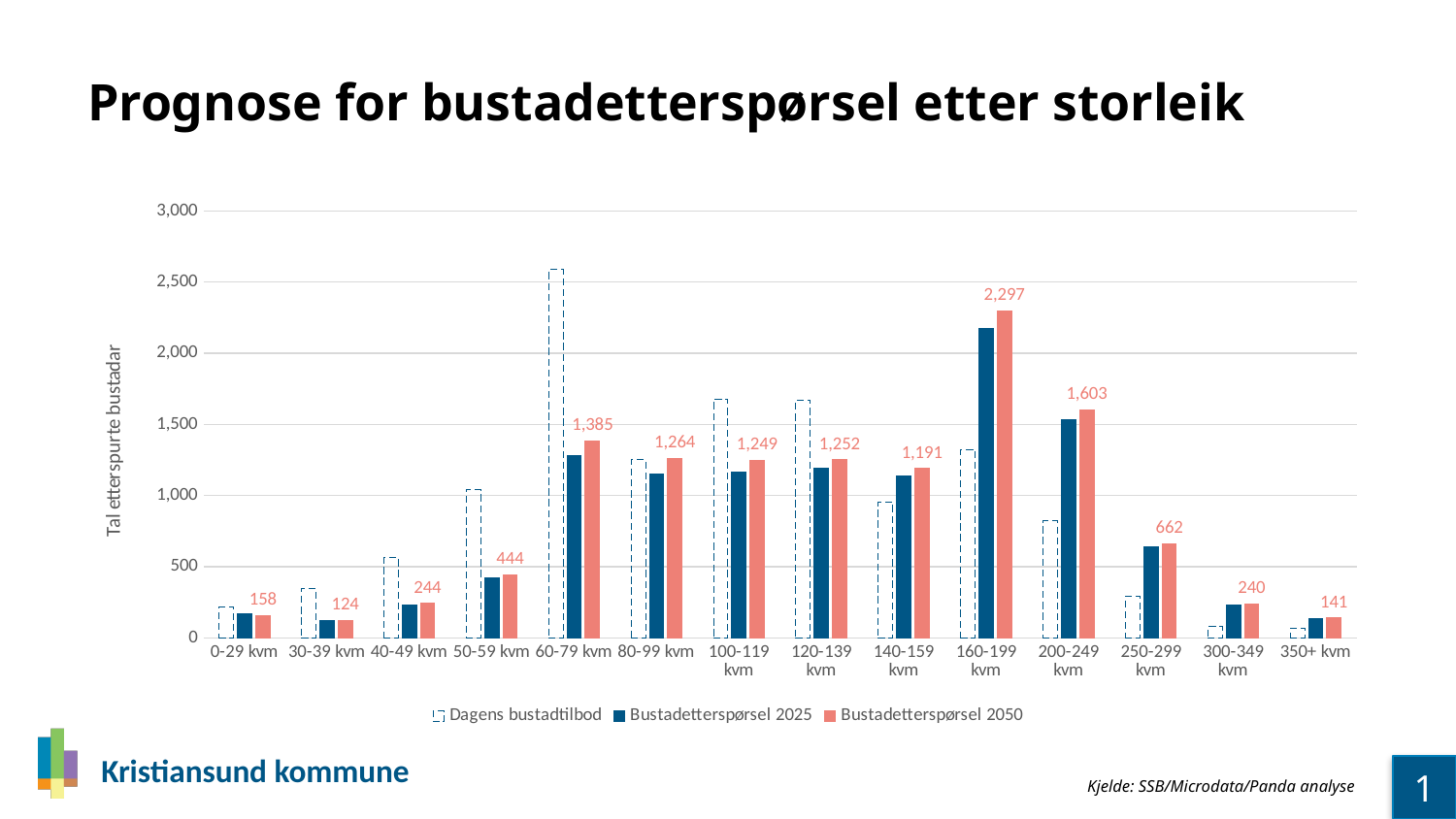
What is the Bustadetterspørsel 2050 value for the 60-79 kvm category? 1,385 How many series does the legend list? 3 What is the Bustadetterspørsel 2050 value for the 160-199 kvm category? 2,297 What is the Bustadetterspørsel 2050 value for the 250-299 kvm category? 662 How many size categories are shown on the x axis? 14 What is the difference between the Bustadetterspørsel 2050 values for 160-199 kvm and 200-249 kvm? 694 Which category has the highest Bustadetterspørsel 2050 value? 160-199 kvm Which is larger: the Bustadetterspørsel 2050 value for 50-59 kvm or for 300-349 kvm? 50-59 kvm What type of chart is shown on the slide? Bar chart Which category has the lowest Bustadetterspørsel 2050 value? 30-39 kvm Is the Dagens bustadtilbod value for 60-79 kvm greater or less than 2,500? greater